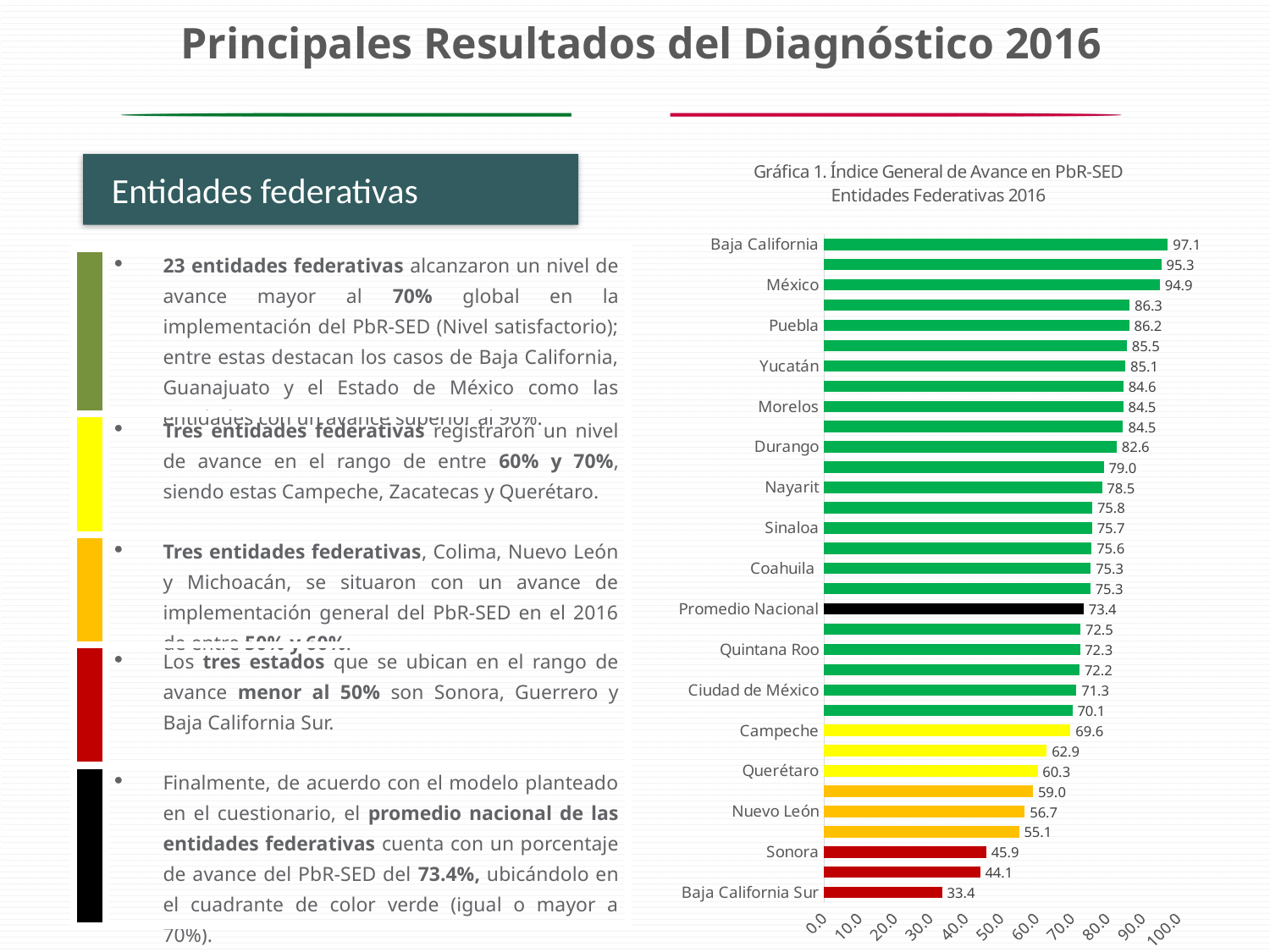
Which has a higher value, Puebla or Yucatán? Puebla How many bars are plotted in the chart? 33 What is the difference between the values for Sonora and Nuevo León? 10.8 What is the value for Baja California Sur? 33.4 Which entity has the lowest value in the chart? Baja California Sur What is the difference between the values for Baja California and Baja California Sur? 63.7 What kind of chart is shown on the slide? Bar chart What is the title of the chart? Gráfica 1. Índice General de Avance en PbR-SED Entidades Federativas 2016 Which entity has the highest value in the chart? Baja California What is the value for Querétaro? 60.3 What is the value for Promedio Nacional? 73.4 What is the value for Baja California? 97.1